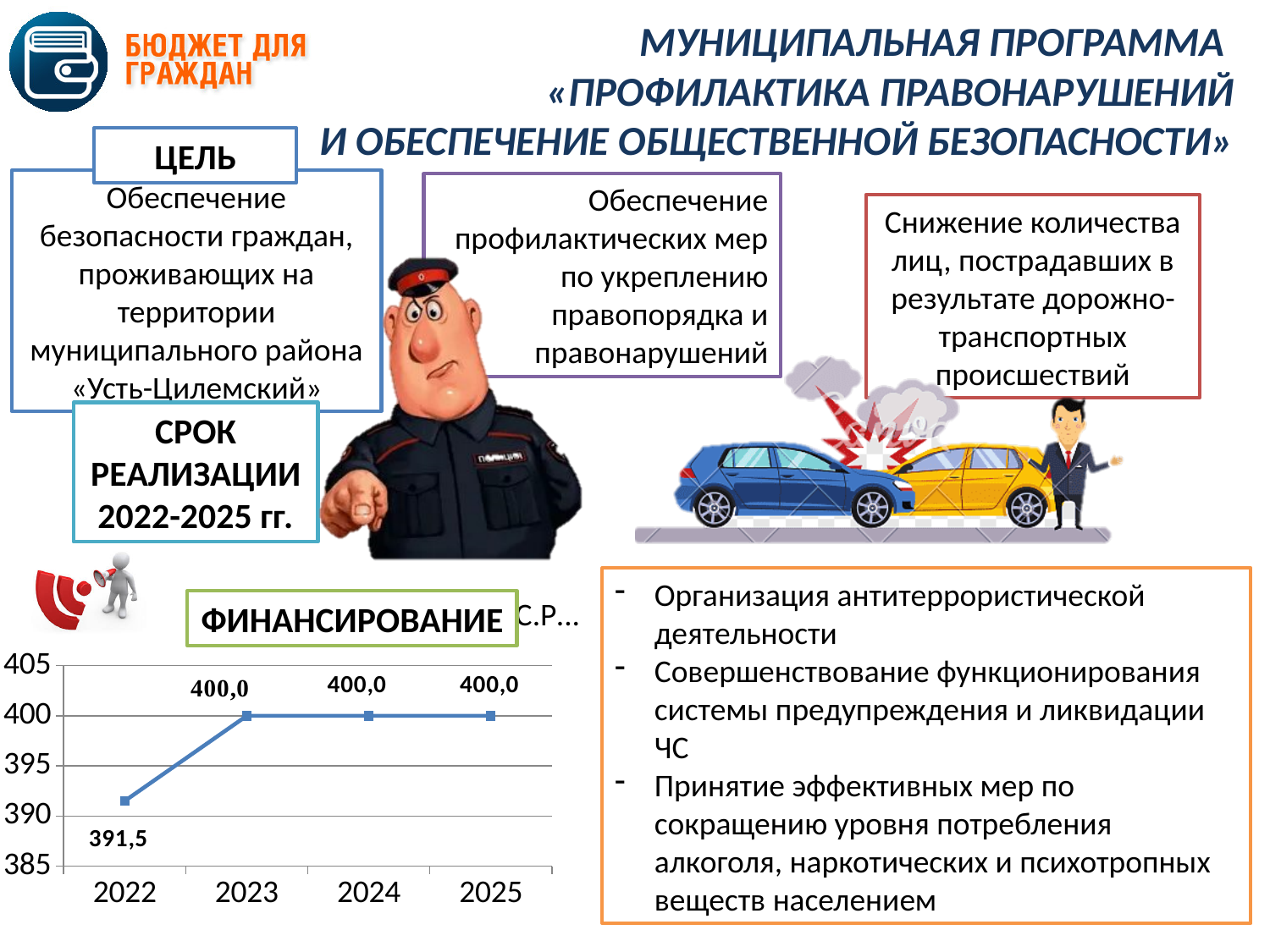
Which year has the lowest value in the line chart? 2022 What is the first year shown on the x axis of the line chart? 2022 Do the values in the line chart rise or fall from 2022 to 2023? rise Is the value for 2022 in the line chart greater or less than 395? less What is the value for 2022 in the line chart? 391,5 What is the value for 2023 in the line chart? 400,0 What is the difference between the values for 2023 and 2022 in the line chart? 8,5 What is the highest tick value shown on the y axis of the line chart? 405 Which is larger in the line chart, the value for 2022 or the value for 2024? 2024 How many years are plotted on the x axis of the line chart? 4 What is the value for 2025 in the line chart? 400,0 What kind of chart is shown at the bottom left of the slide? line chart